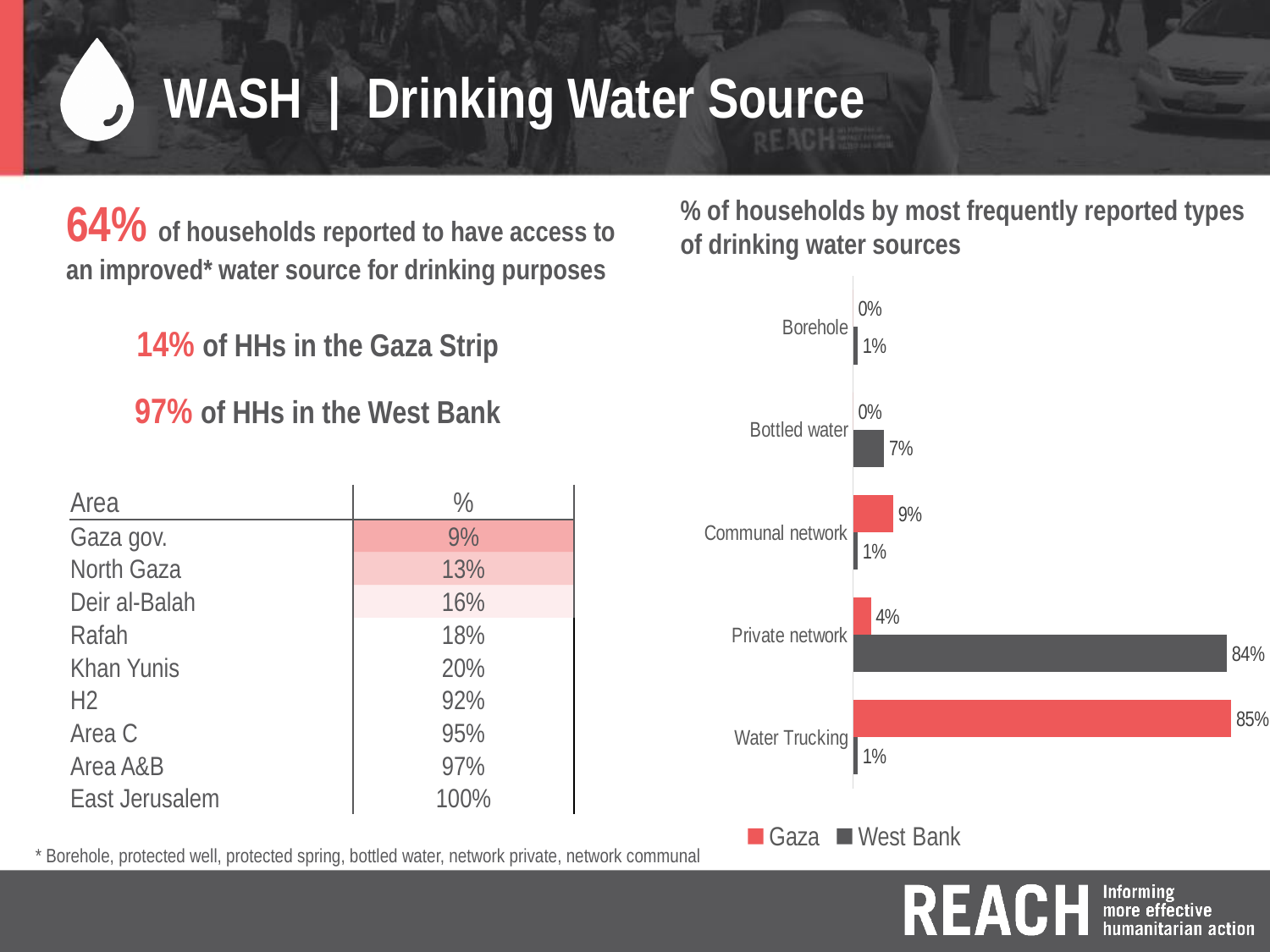
Which drinking water source has the highest value for Gaza? Water Trucking What is the West Bank value for bottled water? 7% What type of chart is used to show the % of households by drinking water source? Bar chart How many series does the chart legend list? 2 Which drinking water source has the highest value for the West Bank? Private network Which colour represents Gaza in the chart? Red What is the Gaza value for communal network? 9% How many drinking water source categories are shown in the chart? 5 What percentage of households in Gaza reported water trucking as their drinking water source? 85% What is the difference between the West Bank and Gaza values for private network? 80% What percentage of households in the West Bank reported a private network as their drinking water source? 84% For communal network, which is larger: the Gaza value or the West Bank value? Gaza